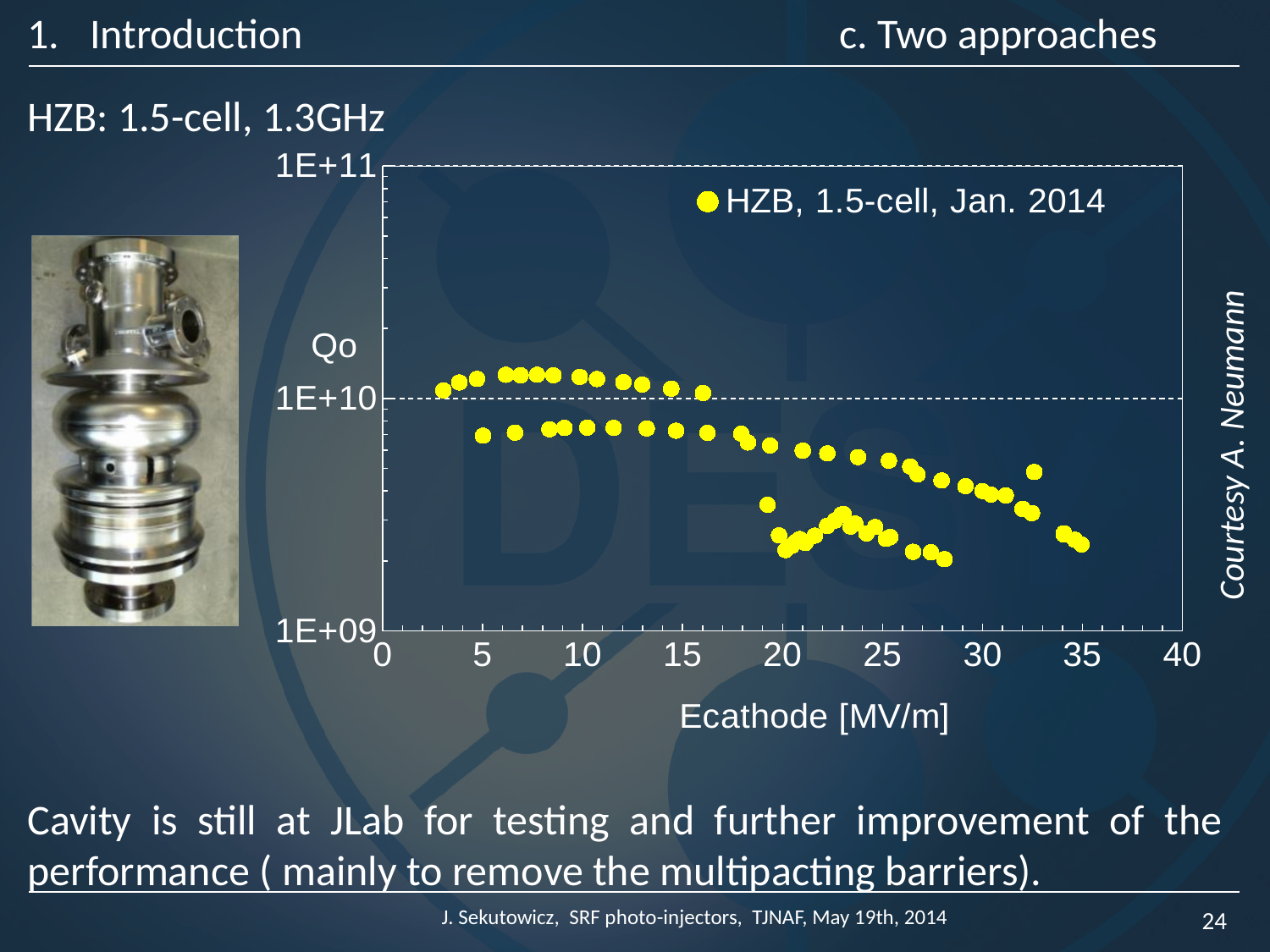
Is the Qo value of the points near Ecathode = 35 MV/m greater or less than 1E+10? less Is the Qo value of the lowest points near Ecathode = 28 MV/m greater or less than 1E+09? greater Which has the higher Qo: the points near Ecathode = 5 MV/m or the points near Ecathode = 35 MV/m? the points near 5 MV/m What kind of chart is shown on the slide? scatter chart What is the maximum value shown on the x axis? 40 What is the legend entry for the plotted series? HZB, 1.5-cell, Jan. 2014 Is the Qo value of the highest points near Ecathode = 10 MV/m greater or less than 1E+10? greater What is the label of the x axis? Ecathode [MV/m] Do the Qo values generally rise or fall as Ecathode increases beyond 15 MV/m? fall How many series does the chart legend list? 1